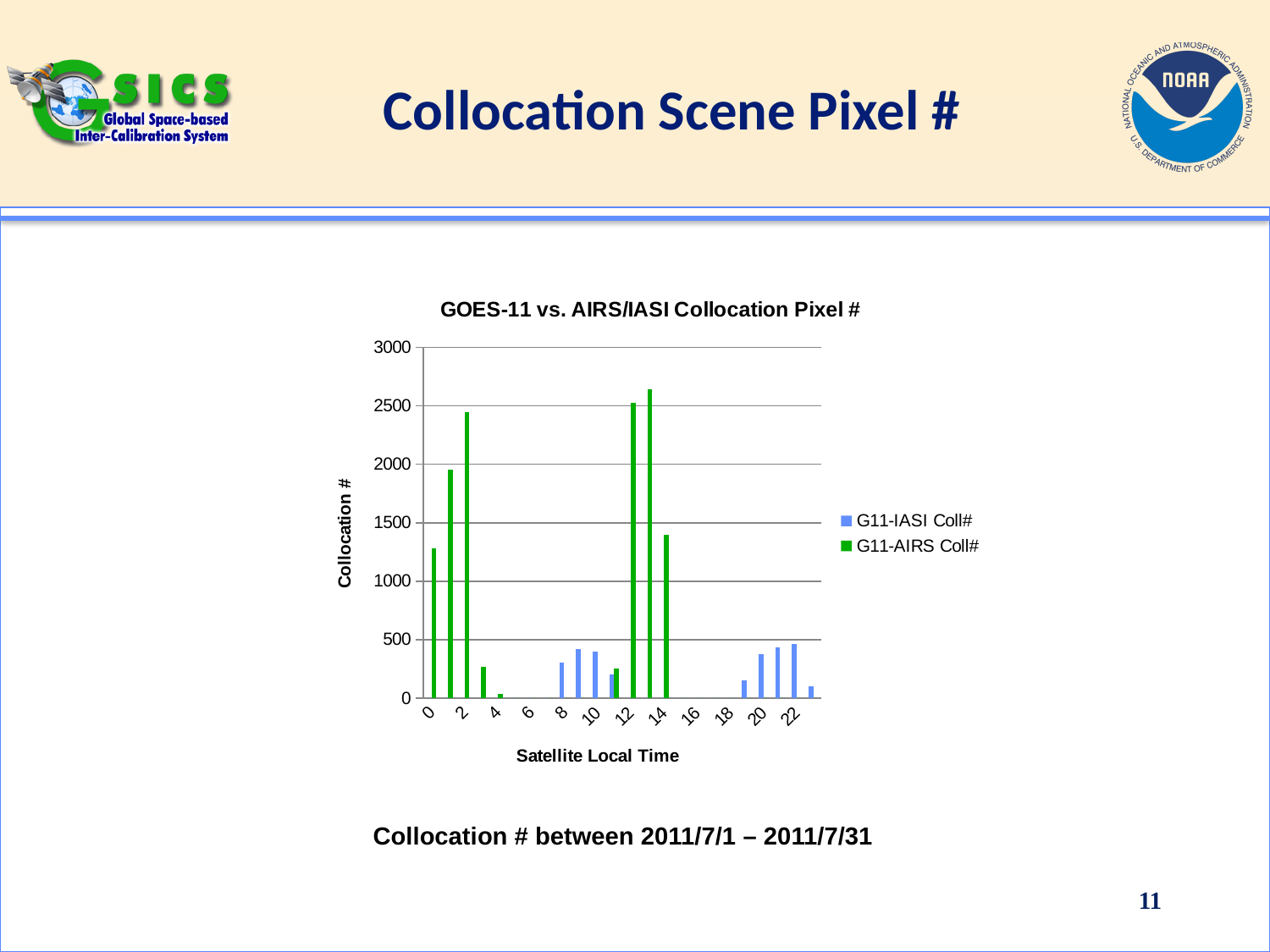
What is the title of the chart? GOES-11 vs. AIRS/IASI Collocation Pixel # Is the G11-AIRS Coll# value at satellite local time 2 greater or less than 2000? greater Is the G11-IASI Coll# value at satellite local time 22 greater or less than 500? less Which is larger, the G11-AIRS Coll# value at satellite local time 14 or at satellite local time 3? satellite local time 14 Which series reaches the highest value on the chart, G11-IASI Coll# or G11-AIRS Coll#? G11-AIRS Coll# Is the G11-AIRS Coll# value at satellite local time 0 greater or less than 1500? less What is the label of the x axis of the chart? Satellite Local Time How many series does the legend of the chart list? 2 What kind of chart is shown on the slide? bar chart Which is larger, the G11-AIRS Coll# value at satellite local time 2 or at satellite local time 0? satellite local time 2